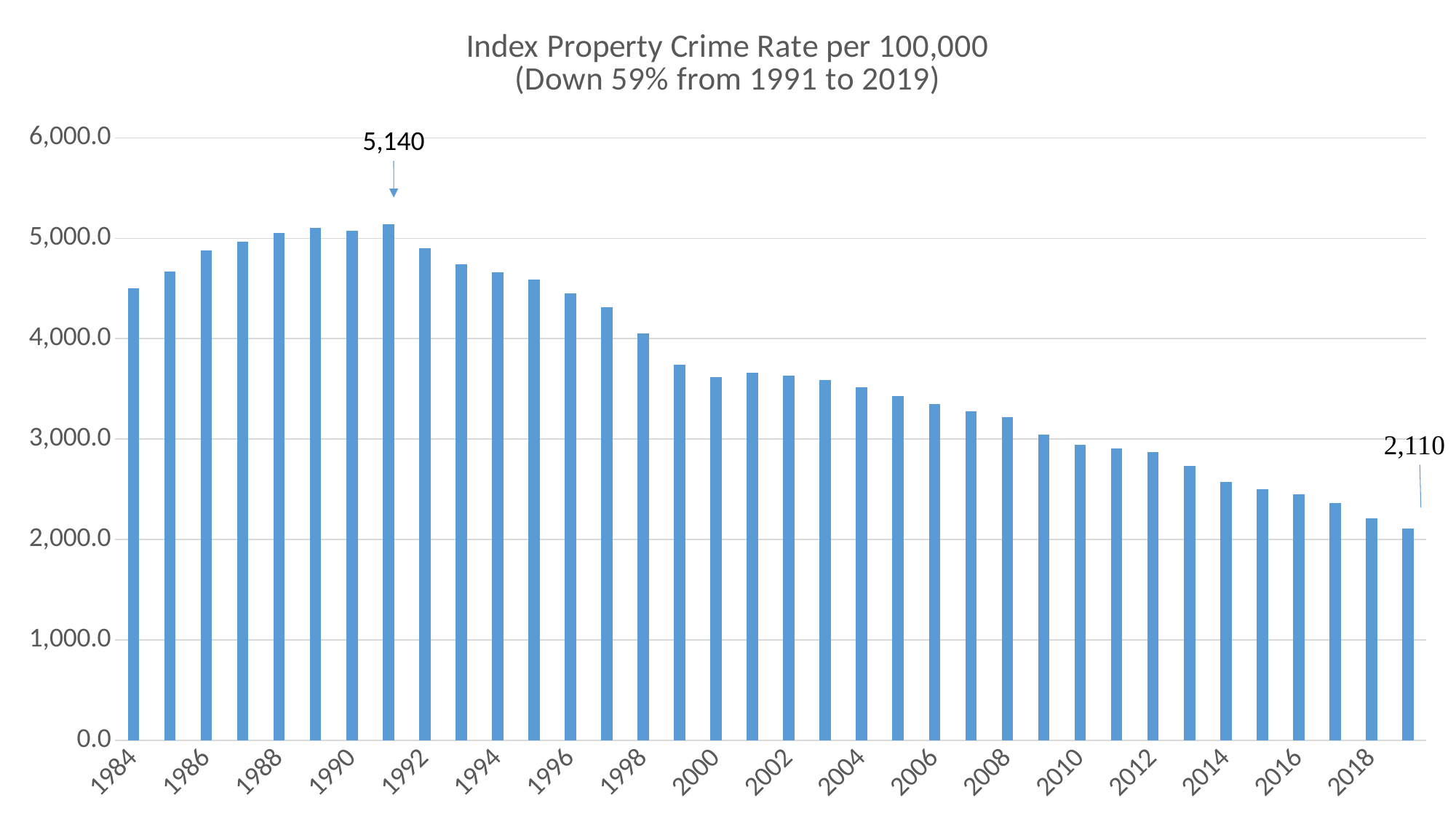
What kind of chart is shown on the slide? bar chart What is the difference between the 1991 rate and the 2019 rate? 3,030 From 1991 to 2019, do the values rise or fall along the x axis? fall Which year has the highest index property crime rate? 1991 Is the value for 2014 greater or less than 3,000? less How many years (bars) are plotted in the chart? 36 Which year has the lowest index property crime rate? 2019 What is the index property crime rate per 100,000 for 2019? 2,110 Which year has the larger index property crime rate, 1991 or 2019? 1991 According to the chart title, by what percentage did the rate fall from 1991 to 2019? 59% What is the index property crime rate per 100,000 for 1991? 5,140 Is the value for 1984 greater or less than 4,000? greater